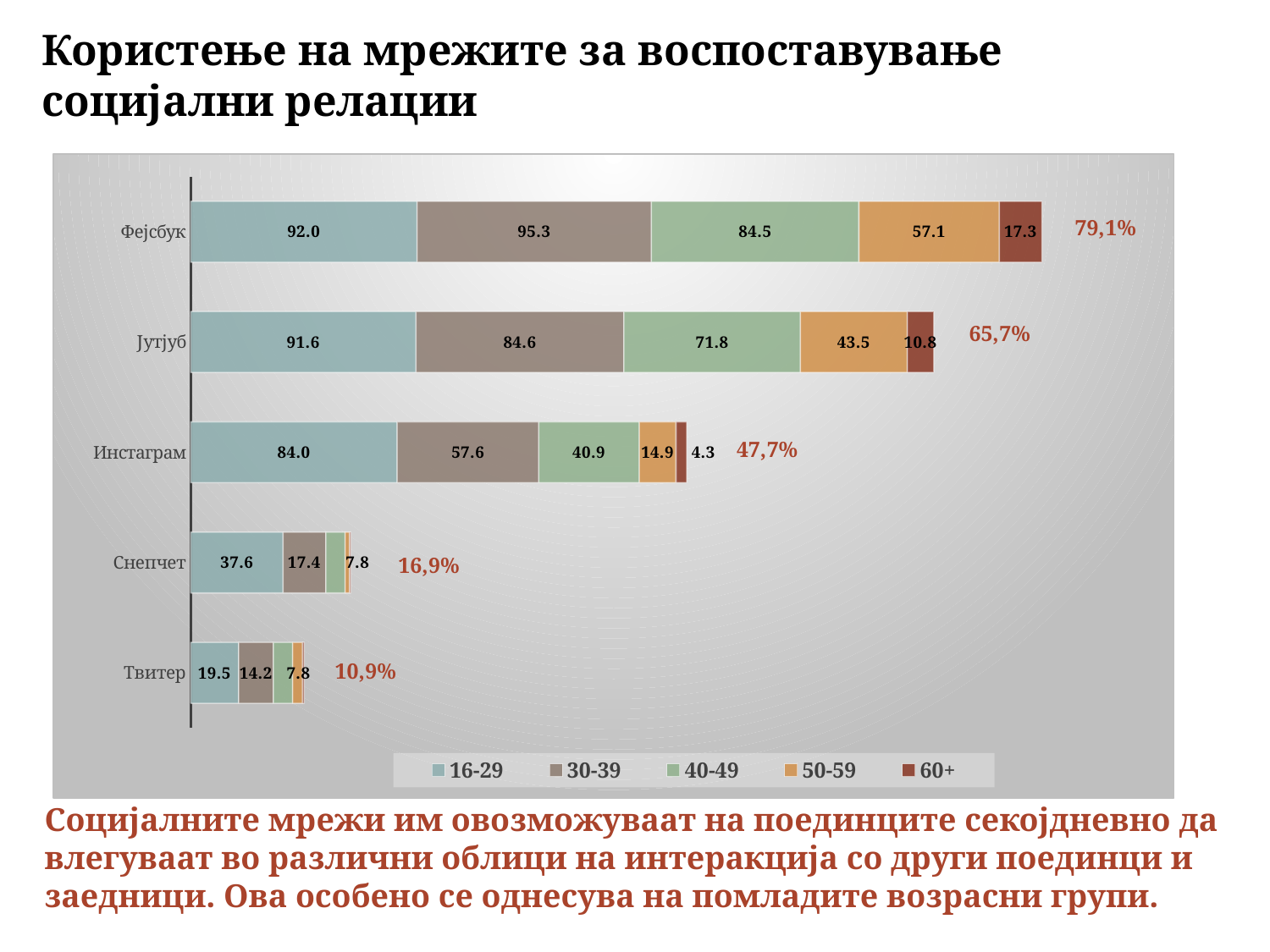
Which is larger: the 30-39 value for Инстаграм or the 40-49 value for Јутјуб? The 40-49 value for Јутјуб What is the value for the 30-39 age group for Фејсбук? 95.3 How many age groups does the legend list? 5 What kind of chart is shown on the slide? Stacked bar chart What is the value for the 16-29 age group for Снепчет? 37.6 How many social networks are shown on the chart? 5 Which network has the lowest value for the 16-29 age group? Твитер What is the difference between the 60+ values for Фејсбук and Јутјуб? 6.5 What is the value for the 50-59 age group for Јутјуб? 43.5 What overall percentage is printed in red next to the Фејсбук bar? 79,1% What is the value for the 60+ age group for Инстаграм? 4.3 What is the difference between the 50-59 values for Фејсбук and Јутјуб? 13.6